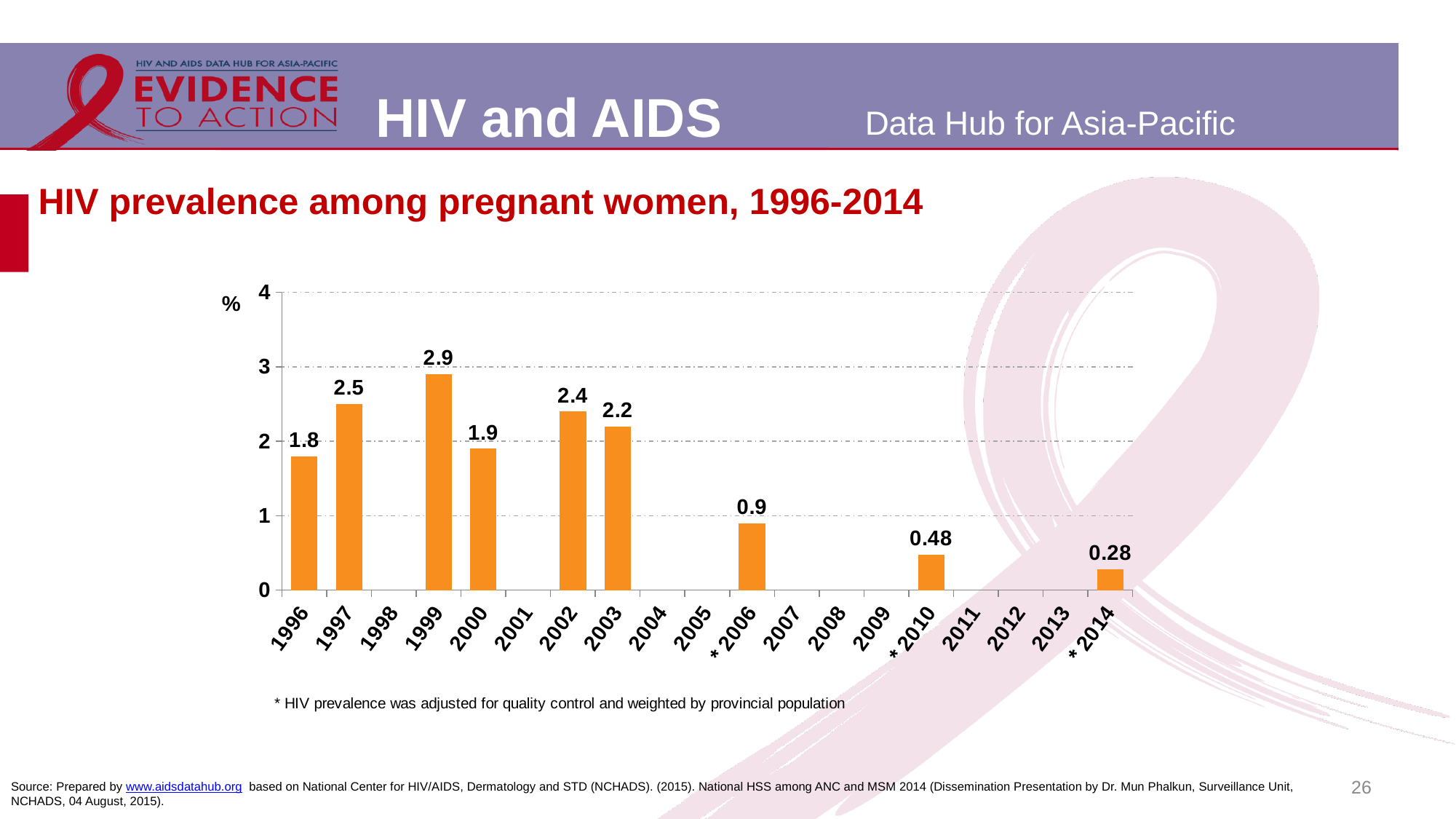
What is the HIV prevalence among pregnant women in 1999? 2.9 Do the values generally rise or fall from 2003 to 2014? fall What is the HIV prevalence among pregnant women in 2010? 0.48 Which year has the lowest HIV prevalence among pregnant women? 2014 What kind of chart is shown on the slide? bar chart What unit is shown on the y axis of the chart? % What is the difference in HIV prevalence between 1997 and 1996? 0.7 How many years have a bar plotted in the chart? 9 What is the HIV prevalence among pregnant women in 2014? 0.28 Which year has a higher HIV prevalence, 2002 or 2003? 2002 Is the value for 2006 greater or less than 1? less Which year has the highest HIV prevalence among pregnant women? 1999